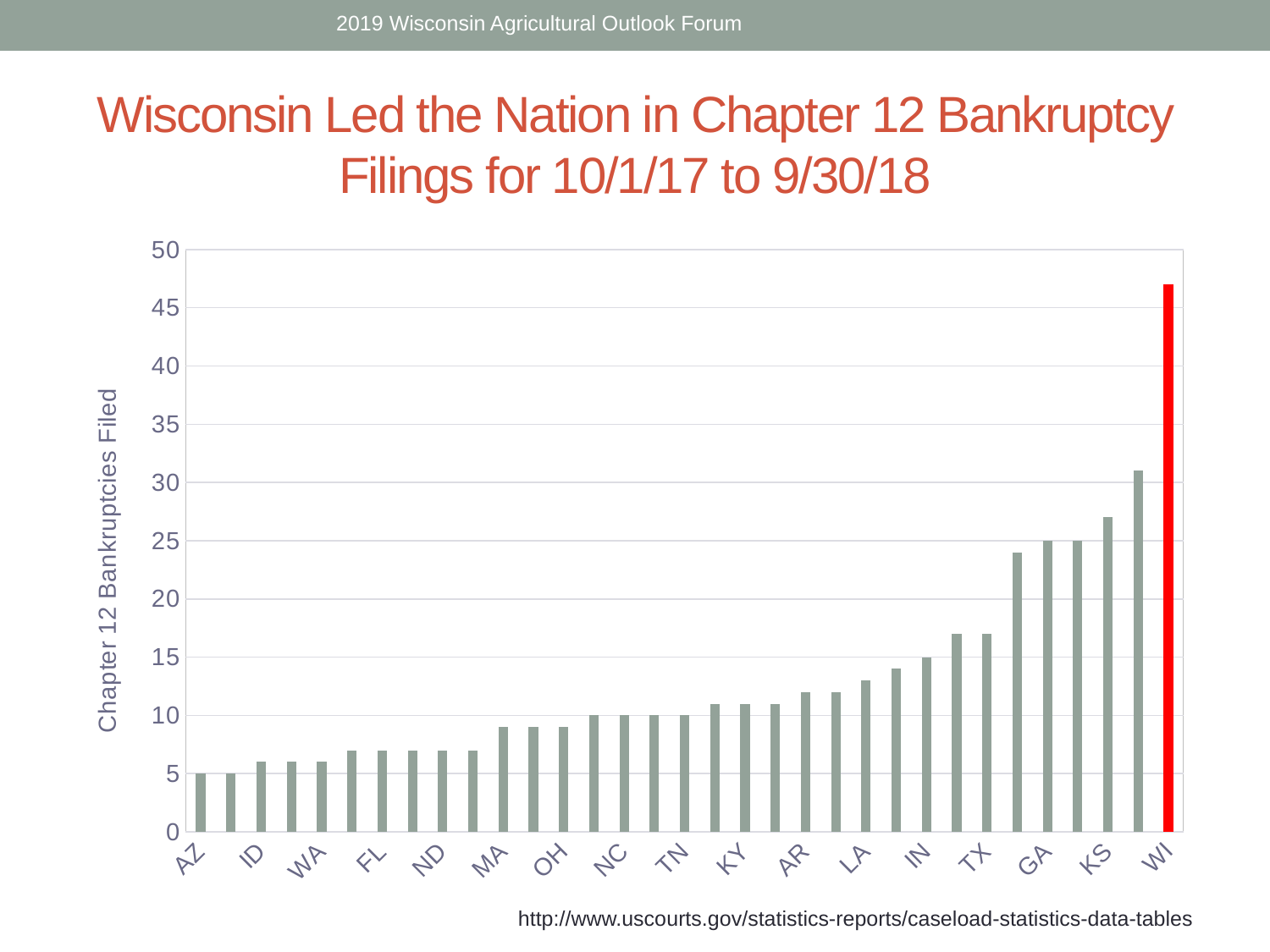
Is the value for KS greater or less than 25? greater Is the value for MA greater or less than 10? less How many Chapter 12 bankruptcies were filed in AZ? 5 Do the values generally rise or fall moving from left to right along the x axis? rise Which state has the highest number of Chapter 12 bankruptcies filed? WI Which state has more Chapter 12 bankruptcies filed, TX or LA? TX What colour is the bar for WI? red How many Chapter 12 bankruptcies were filed in IN? 15 How many Chapter 12 bankruptcies were filed in GA? 25 How many Chapter 12 bankruptcies were filed in NC? 10 What type of chart is shown on the slide? bar chart Is the value for WI greater or less than 45? greater